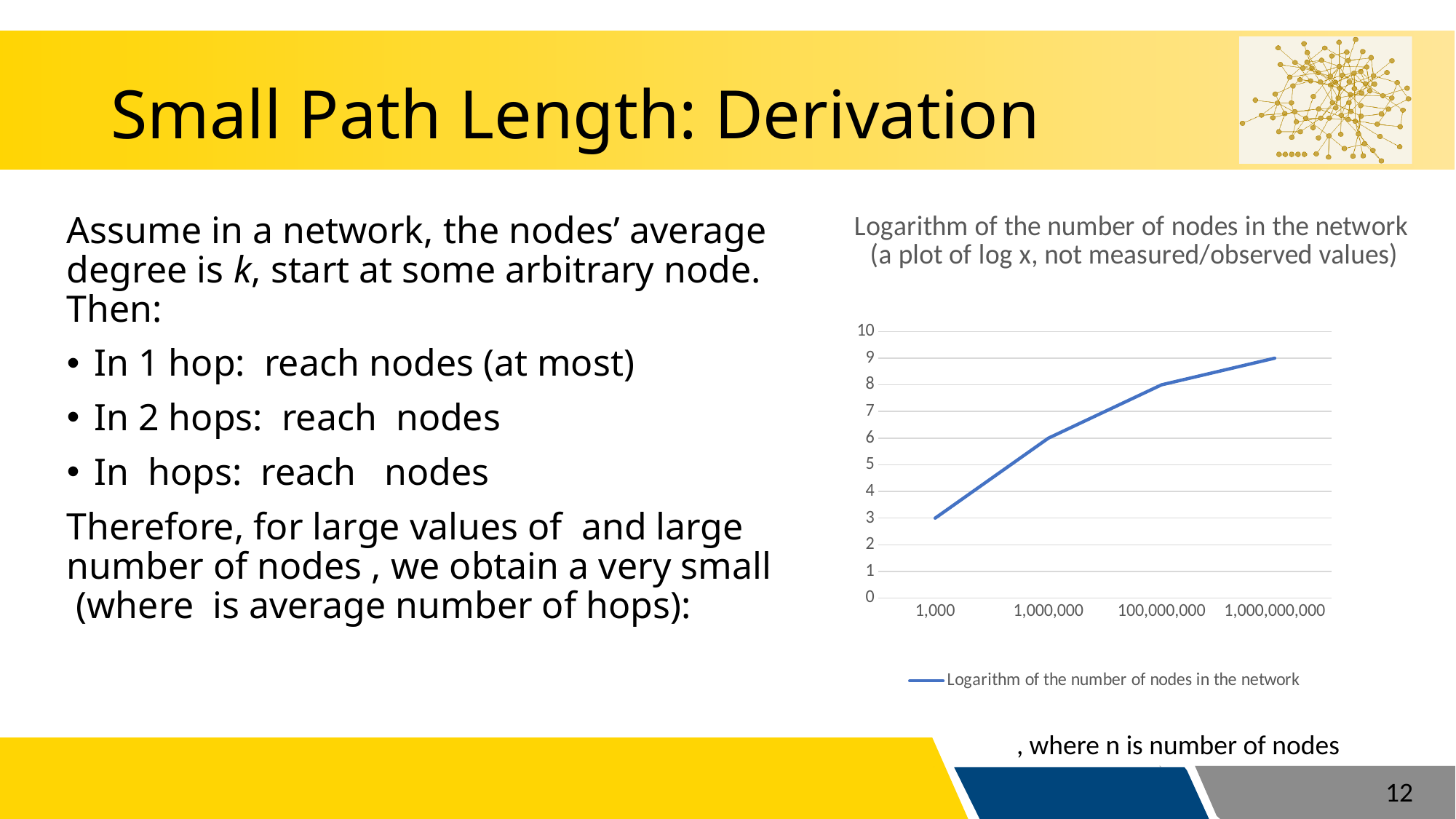
What is the value plotted for 1,000,000,000 nodes? 9 What is the value plotted for 1,000 nodes? 3 How many points are plotted on the line? 4 What kind of chart is shown on the slide? line chart Which x-axis category has the highest plotted value? 1,000,000,000 What is the value plotted for 100,000,000 nodes? 8 How many series does the legend list? 1 What is the title of the chart? Logarithm of the number of nodes in the network (a plot of log x, not measured/observed values) Do the plotted values rise or fall as the number of nodes increases along the x axis? rise Which x-axis category has the lowest plotted value? 1,000 What is the value plotted for 1,000,000 nodes? 6 What is the difference between the values plotted for 1,000,000 and 1,000 nodes? 3